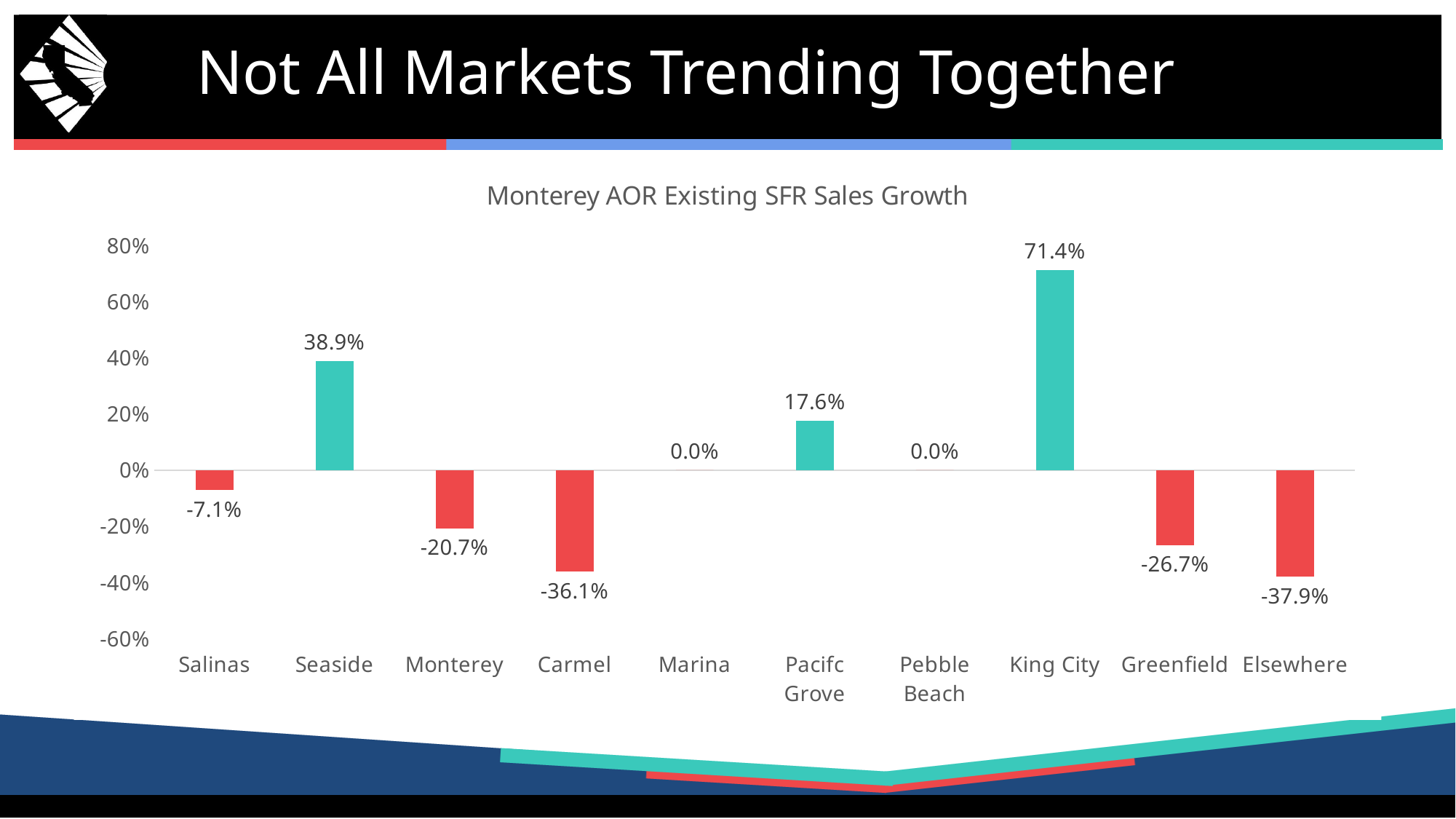
What is the sales growth value for Pacifc Grove? 17.6% What is the sales growth value for Carmel? -36.1% Which category has the lowest sales growth? Elsewhere Which category has the highest sales growth? King City What is the title of the chart? Monterey AOR Existing SFR Sales Growth What kind of chart is shown on the slide? Bar chart What colour are the bars with negative values? Red How many categories are shown on the x axis? 10 Which is larger, the value for Seaside or the value for Pacifc Grove? Seaside What is the sales growth value for Marina? 0.0% What is the sales growth value for King City? 71.4% What is the difference between the values for King City and Seaside? 32.5%